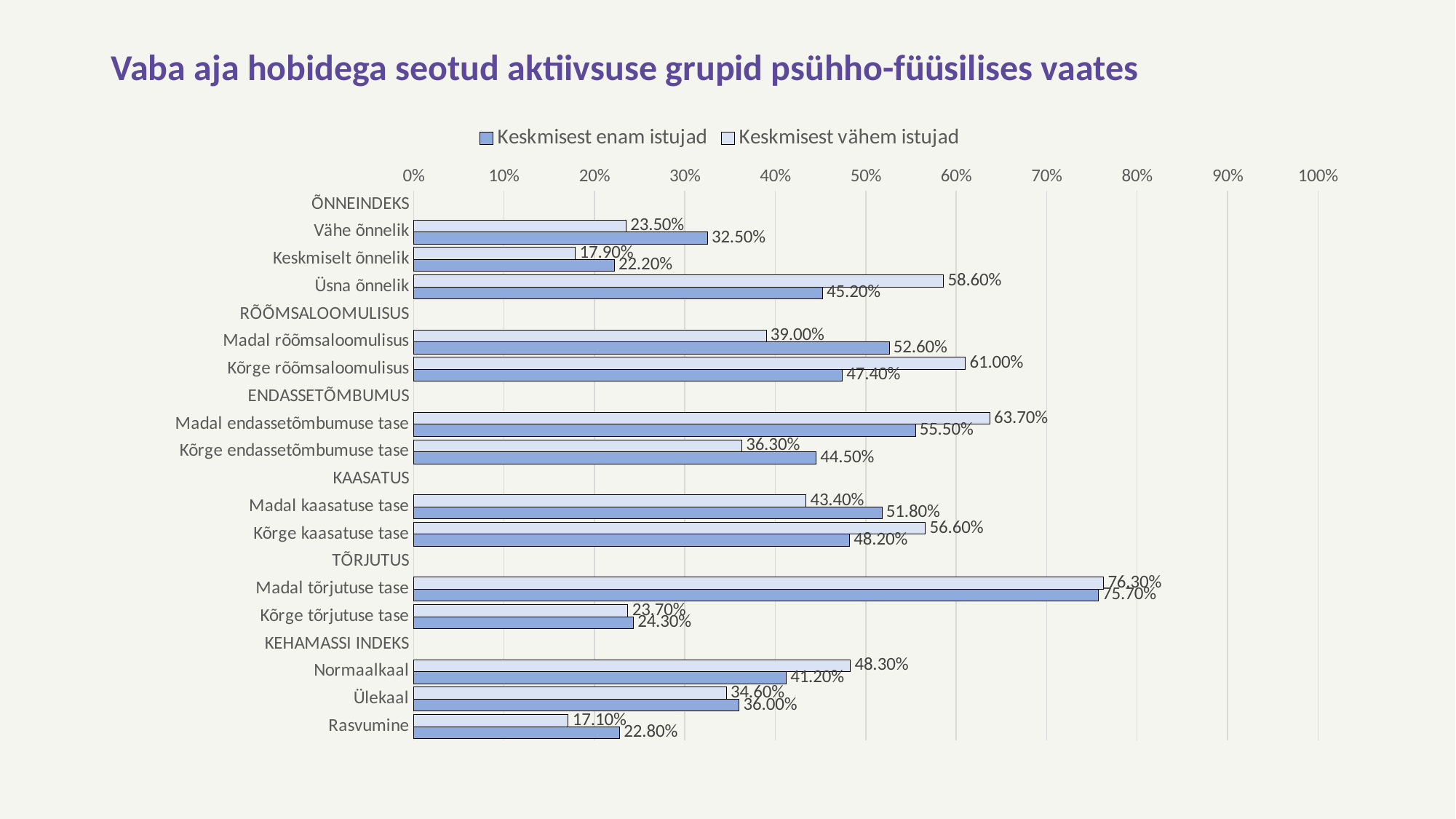
Which is larger for Madal endassetõmbumuse tase: Keskmisest enam istujad or Keskmisest vähem istujad? Keskmisest vähem istujad What kind of chart is shown on the slide? Bar chart Is the Keskmisest vähem istujad value for Normaalkaal greater or less than 40%? greater What is the difference between the Keskmisest vähem istujad and Keskmisest enam istujad values for Kõrge rõõmsaloomulisus? 13.60% What is the title of the chart? Vaba aja hobidega seotud aktiivsuse grupid psühho-füüsilises vaates What is the value for Rasvumine in the Keskmisest enam istujad series? 22.80% What is the value for Madal rõõmsaloomulisus in the Keskmisest enam istujad series? 52.60% Which category has the highest value in the Keskmisest enam istujad series? Madal tõrjutuse tase What is the value for Üsna õnnelik in the Keskmisest vähem istujad series? 58.60% What is the value for Kõrge kaasatuse tase in the Keskmisest vähem istujad series? 56.60% How many series does the legend list? 2 Which category has the lowest value in the Keskmisest vähem istujad series? Rasvumine